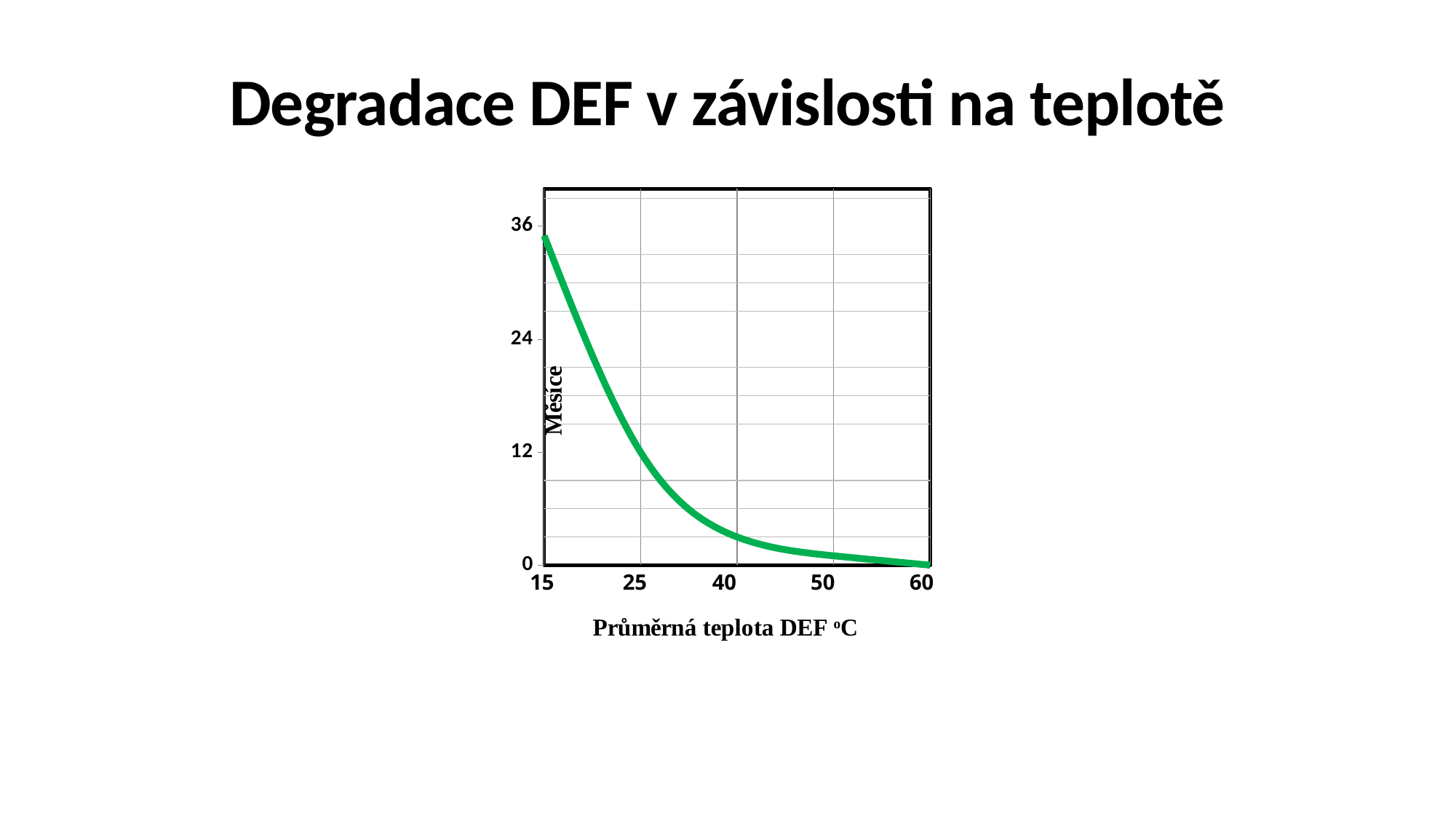
Is the value (Měsíce) at 25 °C greater or less than 24? less Do the values rise or fall as the temperature increases along the x axis? fall What is the title of the chart? Degradace DEF v závislosti na teplotě Is the value (Měsíce) at 40 °C greater or less than 12? less Is the value (Měsíce) at 50 °C greater or less than 12? less At which labelled temperature on the x axis is the value (Měsíce) highest? 15 Which has the larger value (Měsíce): 25 °C or 40 °C? 25 °C What kind of chart is shown on the slide? line chart What is the label of the x axis? Průměrná teplota DEF °C At which labelled temperature on the x axis is the value (Měsíce) lowest? 60